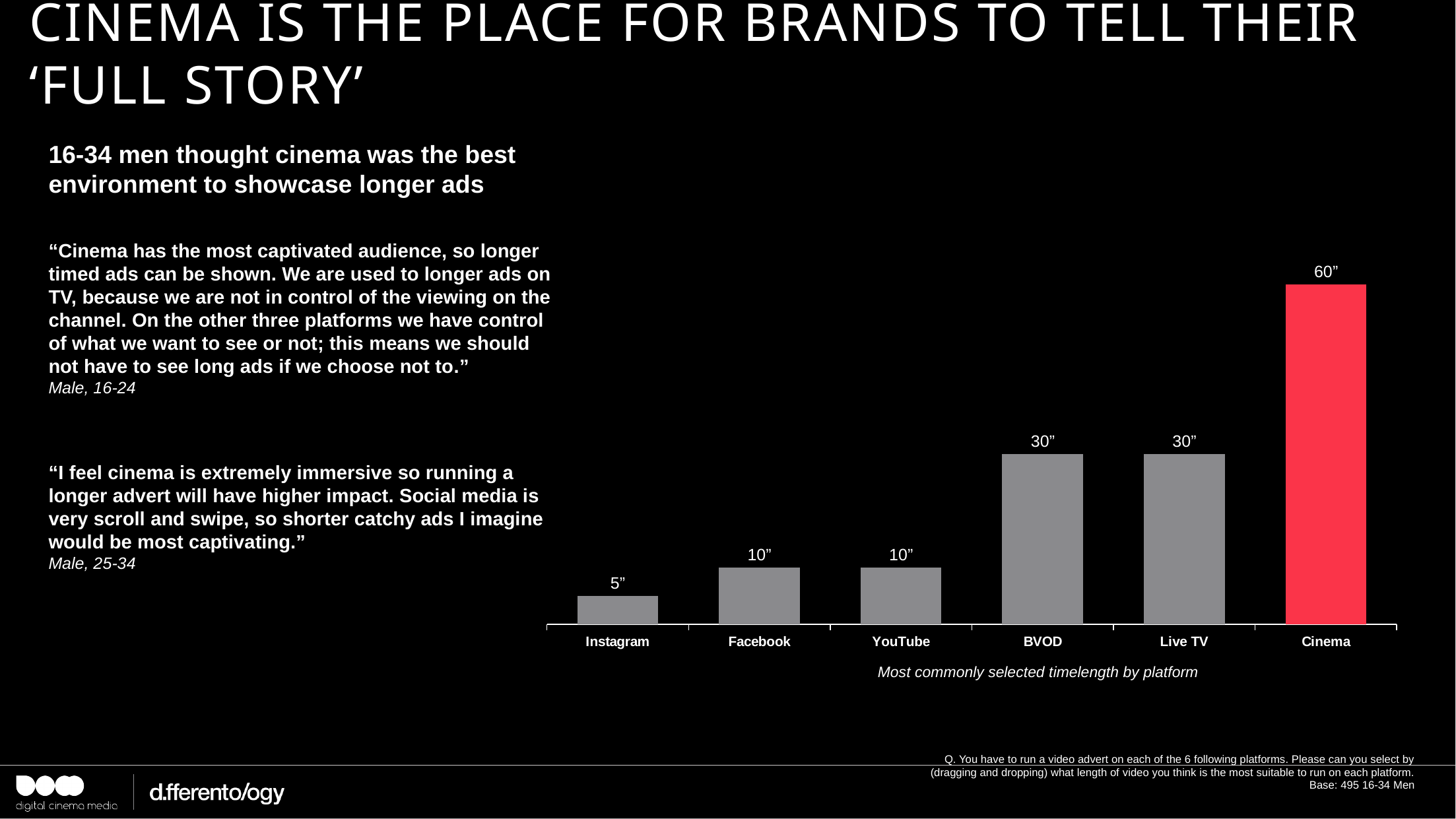
What is the most commonly selected timelength for Cinema? 60” Which bar in the chart is coloured red rather than grey? Cinema What is the most commonly selected timelength for BVOD? 30” Which platform has the highest most commonly selected timelength? Cinema How many platforms are shown in the chart? 6 What is the most commonly selected timelength for Instagram? 5” What is the difference between the timelength for Cinema and the timelength for Live TV? 30” What is the difference between the timelength for YouTube and the timelength for Instagram? 5” Which is larger, the timelength for BVOD or the timelength for Facebook? BVOD What is the most commonly selected timelength for Facebook? 10” Which platform has the lowest most commonly selected timelength? Instagram What kind of chart is shown on the slide? Bar chart